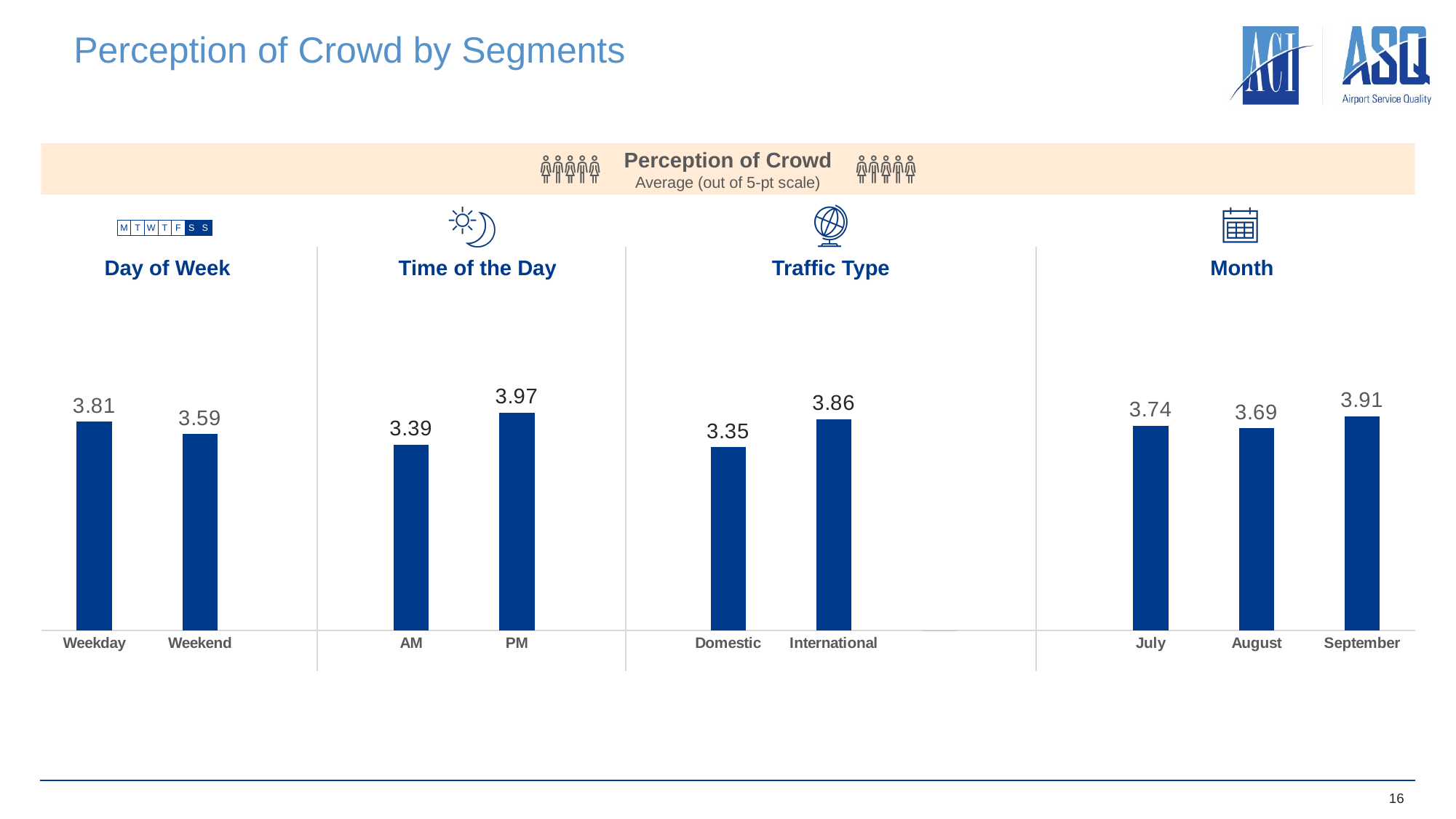
In the Month chart, which month has the highest value? September How many categories are shown in the Month chart? 3 In the Month chart, which month has the lowest value? August In the Traffic Type chart, what is the value for Domestic? 3.35 In the Day of Week chart, what is the value for Weekday? 3.81 What kind of chart is used in the Day of Week section? Bar chart In the Day of Week chart, what is the value for Weekend? 3.59 In the Day of Week chart, what is the difference between the Weekday and Weekend values? 0.22 In the Time of the Day chart, what is the difference between the PM and AM values? 0.58 In the Month chart, what is the value for July? 3.74 In the Time of the Day chart, what is the value for PM? 3.97 In the Traffic Type chart, which category has the higher value, Domestic or International? International